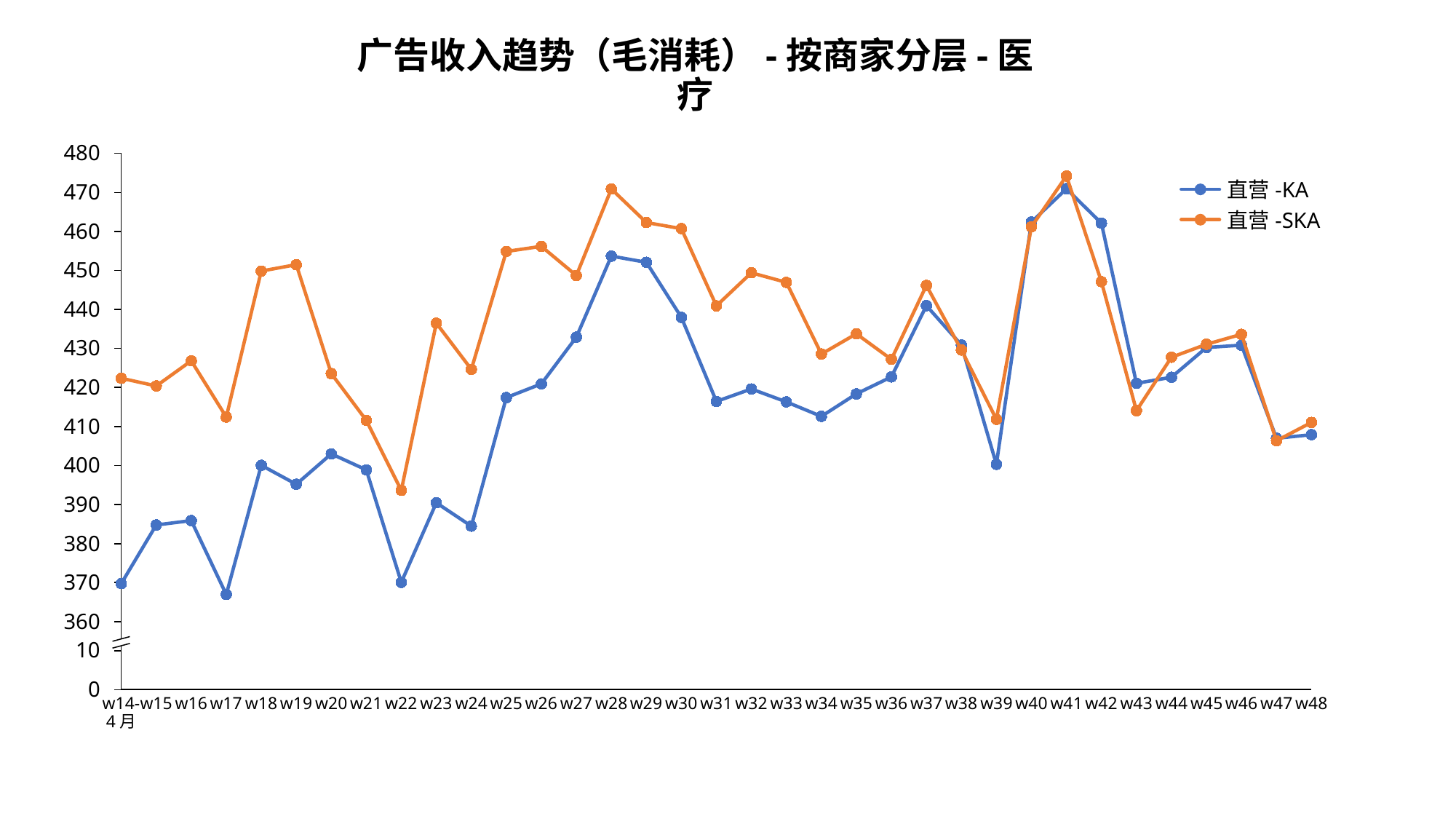
Does the 直营-SKA series rise or fall from w28 to w31? fall How many series does the legend list? 2 In which week does the 直营-KA series reach its highest value? w41 Is the value for 直营-SKA at w28 greater or less than 460? greater In which week does the 直营-SKA series reach its highest value? w41 What kind of chart is shown on the slide? line chart Is the value for 直营-KA at w39 greater or less than 410? less How many weekly points are plotted along the x axis? 35 In which week does the 直营-SKA series reach its lowest value? w22 Is the value for 直营-KA at w14 greater or less than 380? less At w18, which series has the larger value, 直营-KA or 直营-SKA? 直营-SKA Which colour is used for the 直营-SKA series? orange